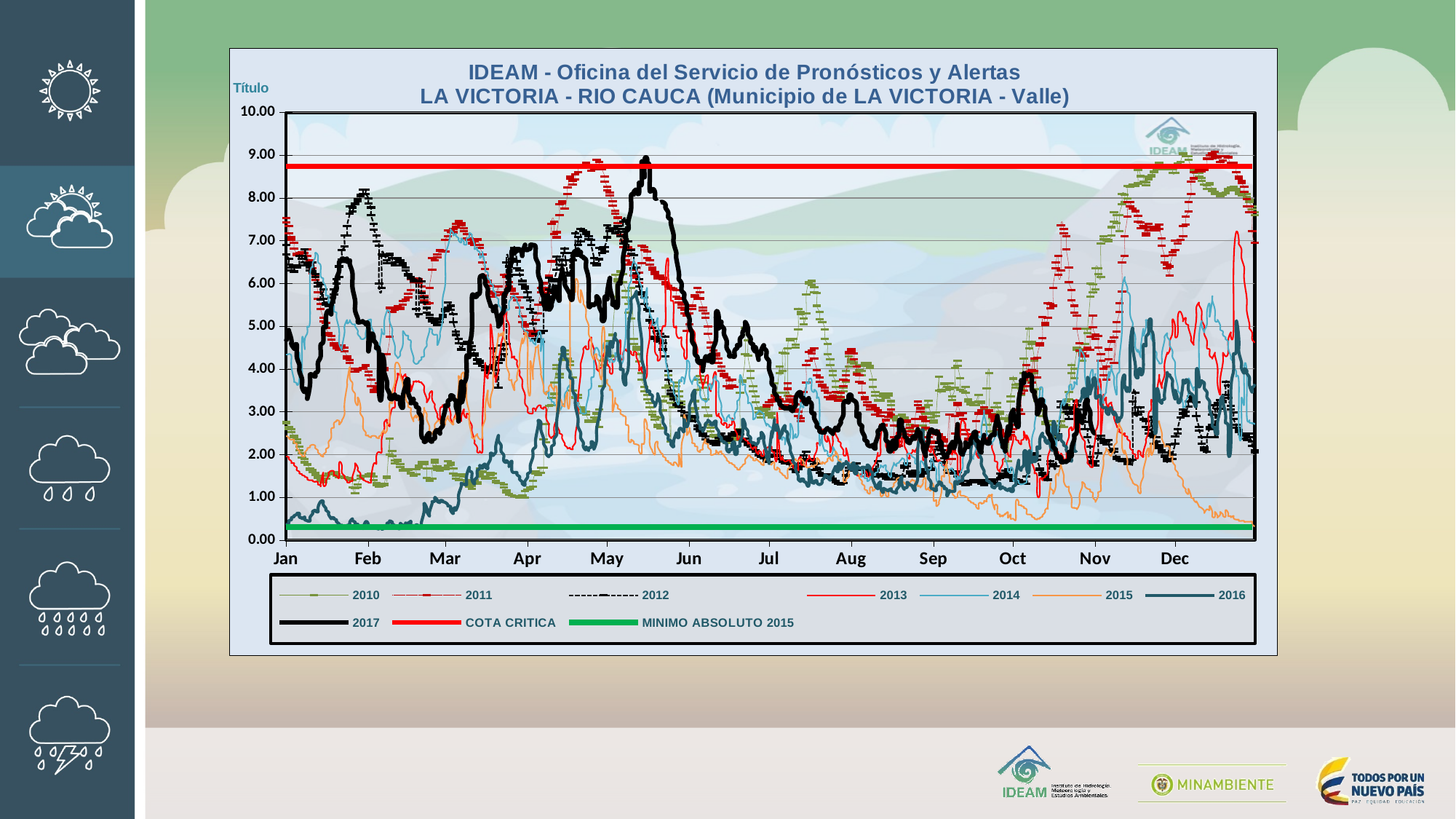
How many months are labelled along the x axis? 12 What colour is the COTA CRITICA line in the legend? red What is the highest value shown on the y axis? 10.00 How many series does the legend list? 10 Is the value of the 2015 series at the end of December greater or less than 1.00? less What kind of chart is shown on the slide? line chart Is the peak value of the 2017 series in late May greater or less than 8.00? greater Is the value of the MINIMO ABSOLUTO 2015 line greater or less than 1.00? less Which horizontal reference line is higher, COTA CRITICA or MINIMO ABSOLUTO 2015? COTA CRITICA